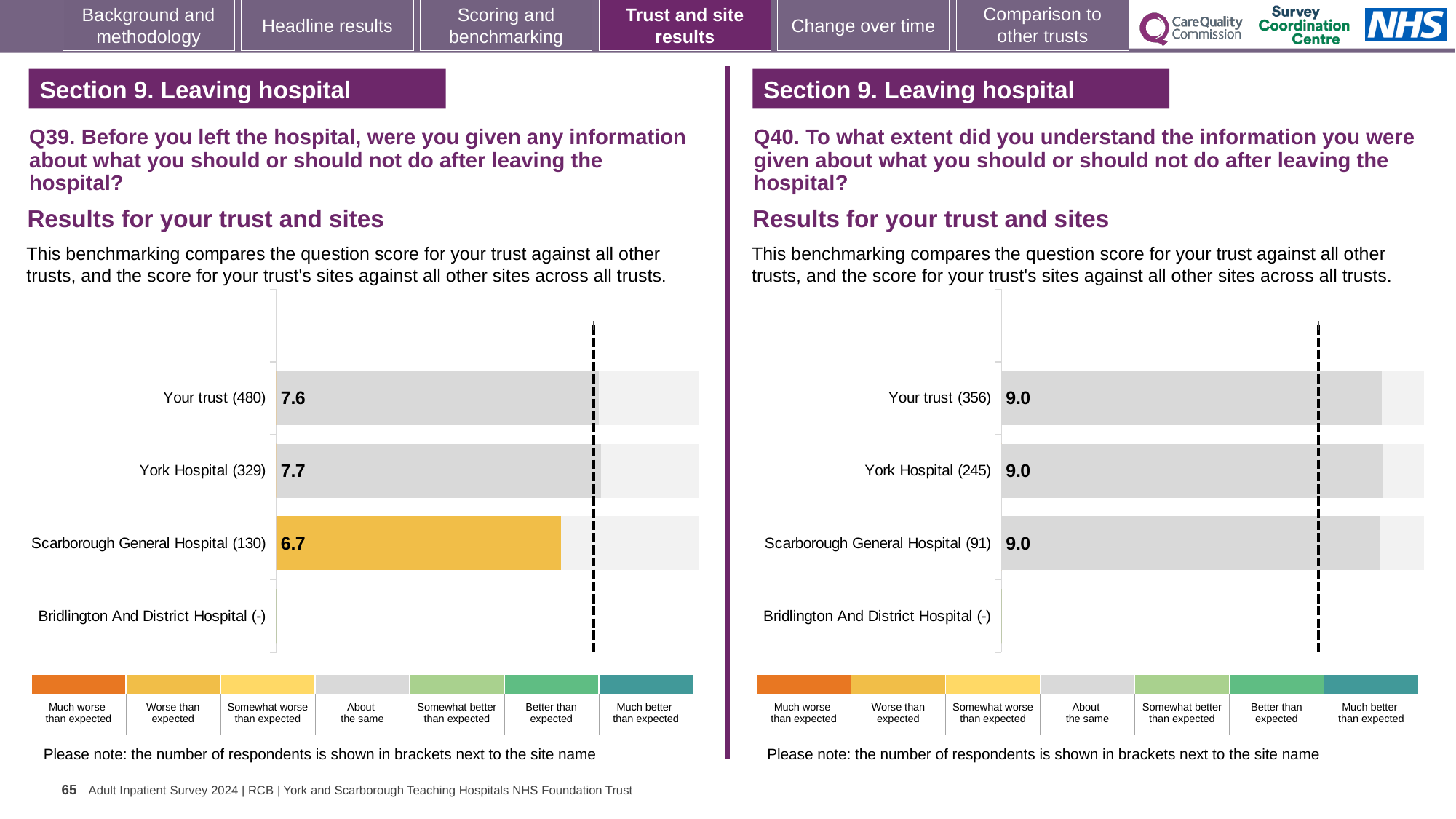
In the Q39 chart on the left, which site or trust has the lowest score? Scarborough General Hospital In the Q39 chart on the left, what is the score for Your trust? 7.6 In the Q40 chart on the right, what is the score for Scarborough General Hospital? 9.0 In the Q39 chart on the left, which has the larger score, Your trust or Scarborough General Hospital? Your trust In the Q40 chart on the right, how many respondents are shown in brackets for York Hospital? 245 In the Q39 chart on the left, which site or trust has the highest score? York Hospital In the Q39 chart on the left, what is the score for York Hospital? 7.7 In the Q39 chart on the left, what is the difference between the York Hospital score and the Scarborough General Hospital score? 1.0 How many sites or trusts are listed on the y axis of the Q39 chart on the left? 4 In the Q39 chart on the left, what is the score for Scarborough General Hospital? 6.7 What kind of chart is used for the Q40 results on the right? Bar chart In the Q40 chart on the right, what is the score for Your trust? 9.0